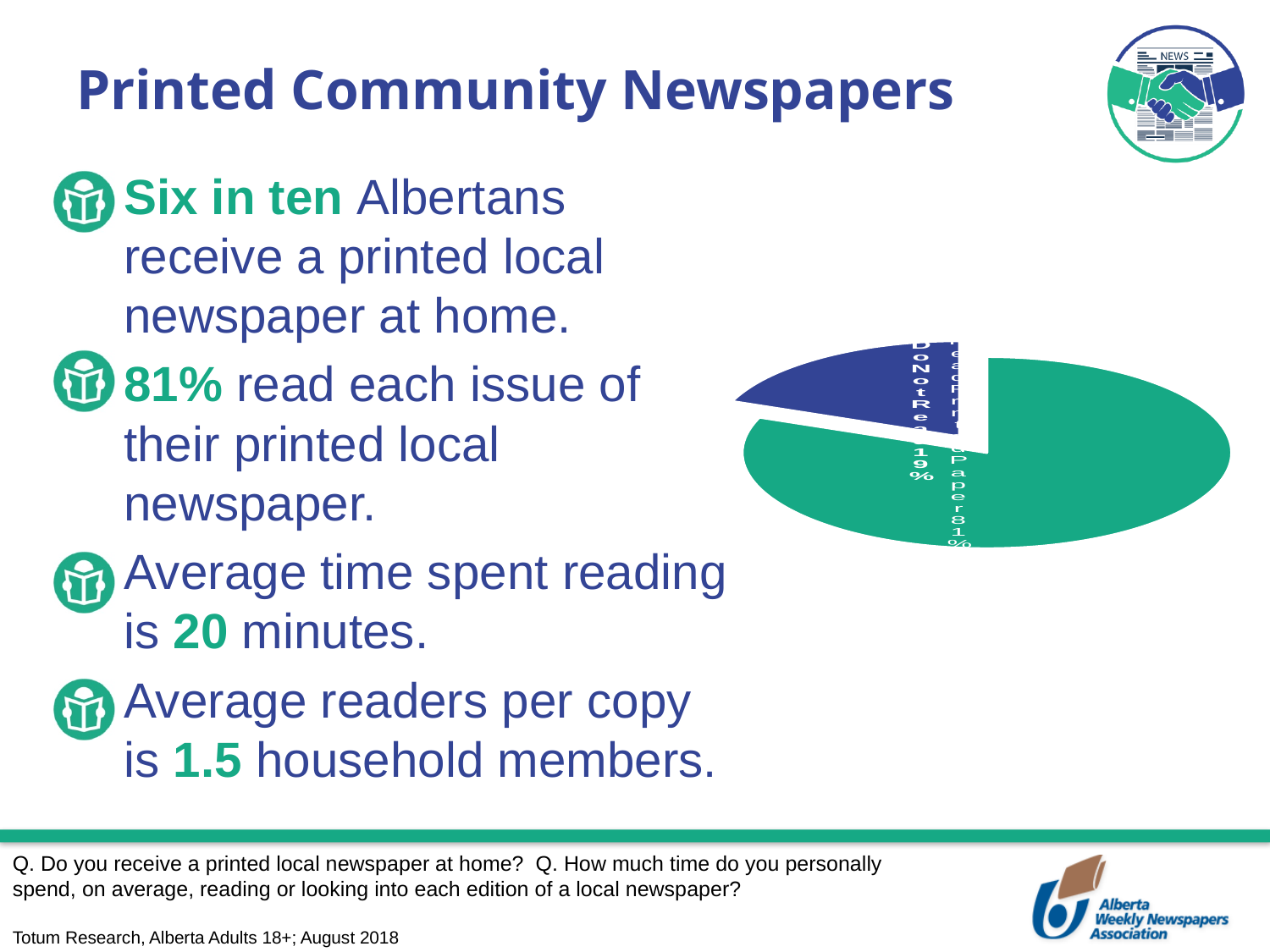
What colour is the "Read Paper" slice of the pie chart? green What kind of chart is shown on the slide? pie chart What share of the pie does the "Do Not Read" slice represent? 19% What is the difference in percentage points between the "Read Paper" slice and the "Do Not Read" slice? 62 What percentage of the pie chart is labelled "Read Paper"? 81% Which is larger in the pie chart, the "Read Paper" slice or the "Do Not Read" slice? Read Paper What percentage of the pie chart is labelled "Do Not Read"? 19% Which slice of the pie chart is the smallest? Do Not Read How many slices does the pie chart have? 2 What colour is the "Do Not Read" slice of the pie chart? dark blue Which slice of the pie chart is the largest? Read Paper